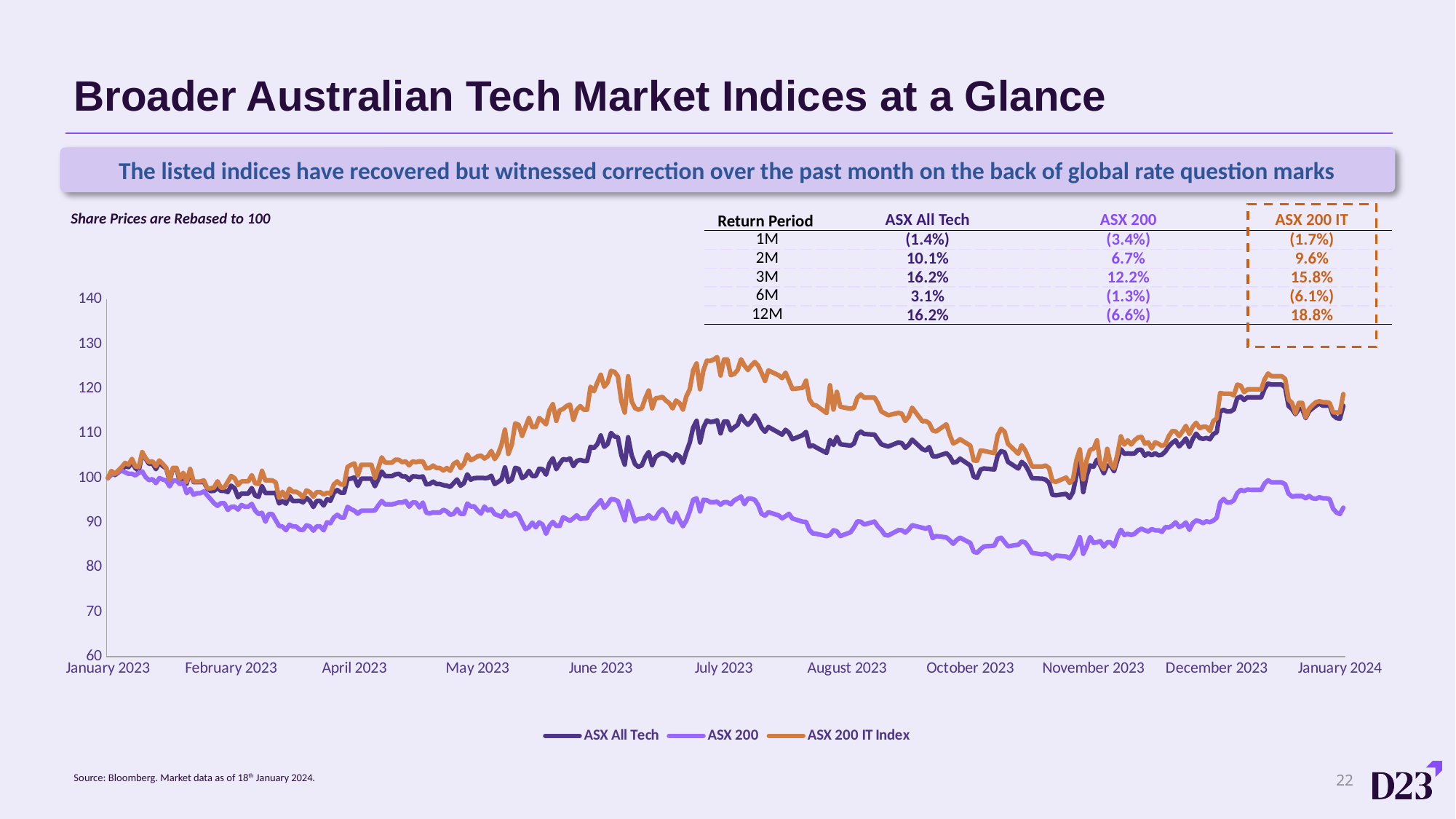
What kind of chart is shown on the slide? Line chart Is the value for ASX 200 in January 2024 greater or less than 100? less Does the ASX 200 line end higher or lower in January 2024 than where it started in January 2023? lower How many series does the chart legend list? 3 Which series is the lowest at the end of the chart in January 2024? ASX 200 In the return table, what is the 12M return for ASX 200 IT? 18.8% Does the ASX All Tech line end higher or lower in January 2024 than where it started in January 2023? higher Is the value for ASX 200 in October 2023 greater or less than 90? less Which series are listed in the chart legend? ASX All Tech, ASX 200, ASX 200 IT Index Is the peak value for ASX 200 IT Index around July 2023 greater or less than 120? greater What value are the share prices in the chart rebased to? 100 Which series reaches the highest peak on the chart? ASX 200 IT Index